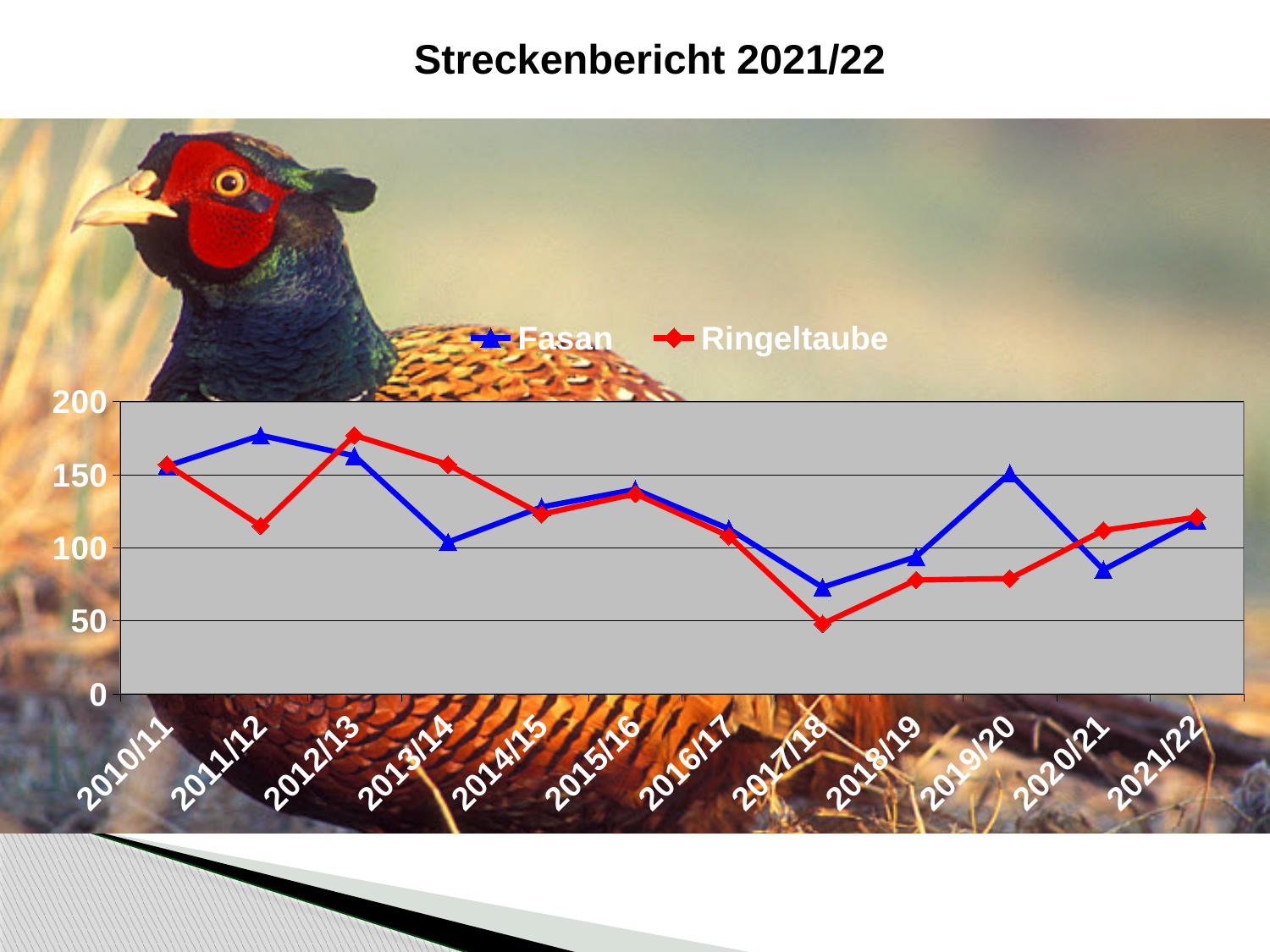
How many series does the legend list? 2 Is the Fasan value for 2013/14 greater or less than 150? less In which season is the Ringeltaube value highest? 2012/13 In which season is the Ringeltaube value lowest? 2017/18 In which season is the Fasan value lowest? 2017/18 Is the Ringeltaube value for 2017/18 greater or less than 100? less Which colour is used for the Fasan series? blue In which season is the Fasan value highest? 2011/12 Is the Fasan value for 2019/20 greater or less than 100? greater How many seasons are shown along the x axis? 12 In 2013/14, which series has the larger value, Fasan or Ringeltaube? Ringeltaube What kind of chart is shown on the slide? line chart